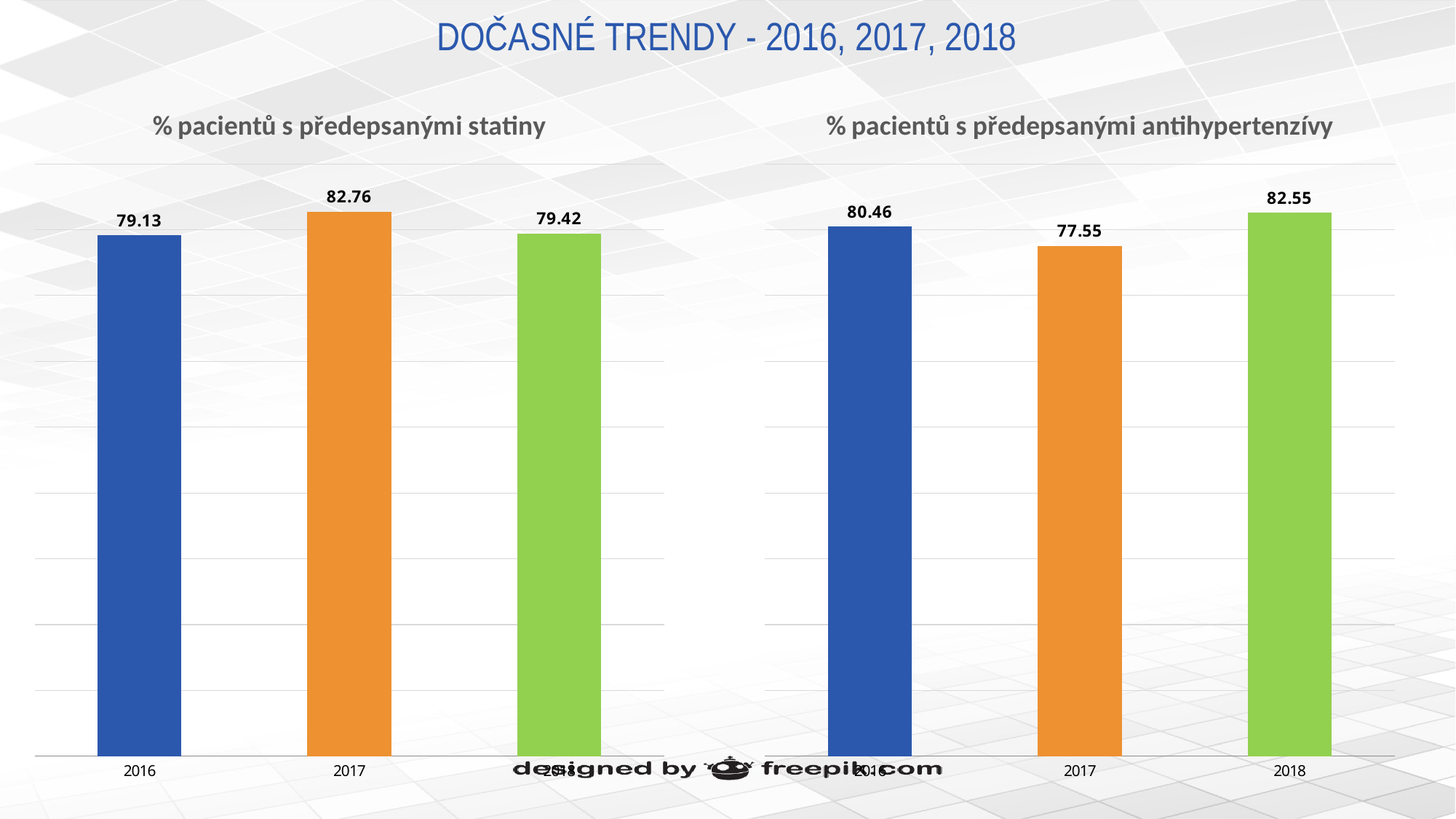
In the chart titled '% pacientů s předepsanými antihypertenzívy', what is the value for 2017? 77.55 In the chart titled '% pacientů s předepsanými antihypertenzívy', which year has the highest value? 2018 In the chart titled '% pacientů s předepsanými antihypertenzívy', what is the value for 2018? 82.55 In the chart titled '% pacientů s předepsanými statiny', which year has the highest value? 2017 What type of chart is the chart titled '% pacientů s předepsanými antihypertenzívy'? bar chart How many bars are in the chart titled '% pacientů s předepsanými statiny'? 3 In the chart titled '% pacientů s předepsanými antihypertenzívy', which year has the lowest value? 2017 In the chart titled '% pacientů s předepsanými antihypertenzívy', what is the difference between the values for 2018 and 2017? 5 In the chart titled '% pacientů s předepsanými statiny', what is the difference between the values for 2017 and 2016? 3.63 In the chart titled '% pacientů s předepsanými statiny', what is the value for 2017? 82.76 In the chart titled '% pacientů s předepsanými antihypertenzívy', which is larger, the value for 2016 or the value for 2017? 2016 In the chart titled '% pacientů s předepsanými statiny', what is the value for 2016? 79.13